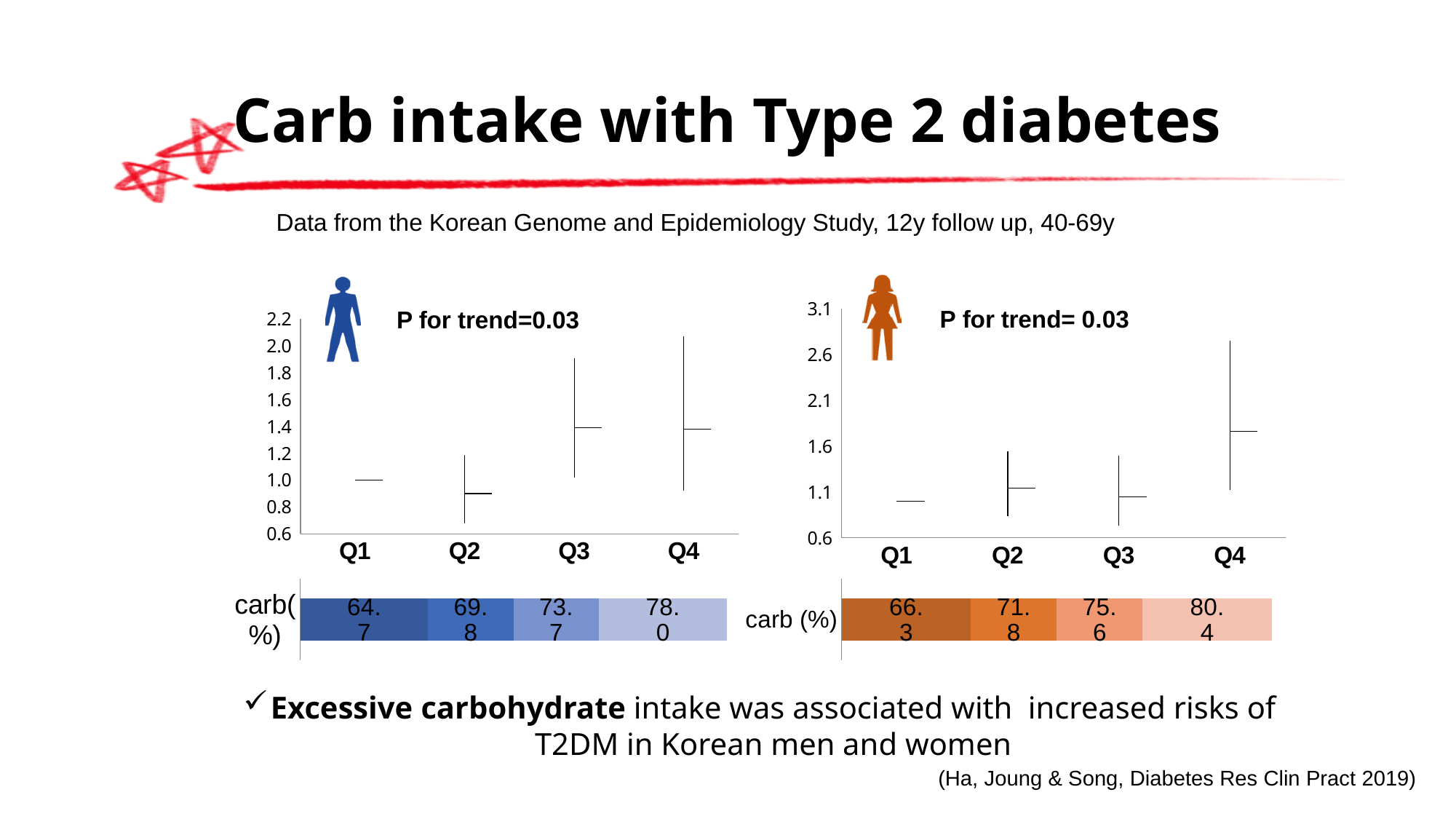
In the carb (%) bar under the right (women) chart, do the carb percentages rise or fall from Q1 to Q4? rise On the right (women) chart, which quartile has the highest plotted value? Q4 In the carb (%) bar under the right (women) chart, what is the carb percentage for Q4? 80.4 On the left (men) chart, how many quartile categories are shown on the x axis? 4 On the right (women) chart, is the value for Q4 greater or less than 1.6? greater On the left (men) chart, is the value for Q3 greater or less than 1.2? greater On the left (men) chart, which is larger, the value for Q2 or the value for Q3? Q3 On the left (men) chart, what is the plotted value for Q1? 1.0 On the left (men) chart, is the value for Q2 greater or less than 1.0? less In the carb (%) bar under the left (men) chart, what is the difference between the Q4 and Q1 carb percentages? 13.3 What P for trend value is shown on the left (men) chart? 0.03 In the carb (%) bar under the left (men) chart, what is the carb percentage for Q1? 64.7